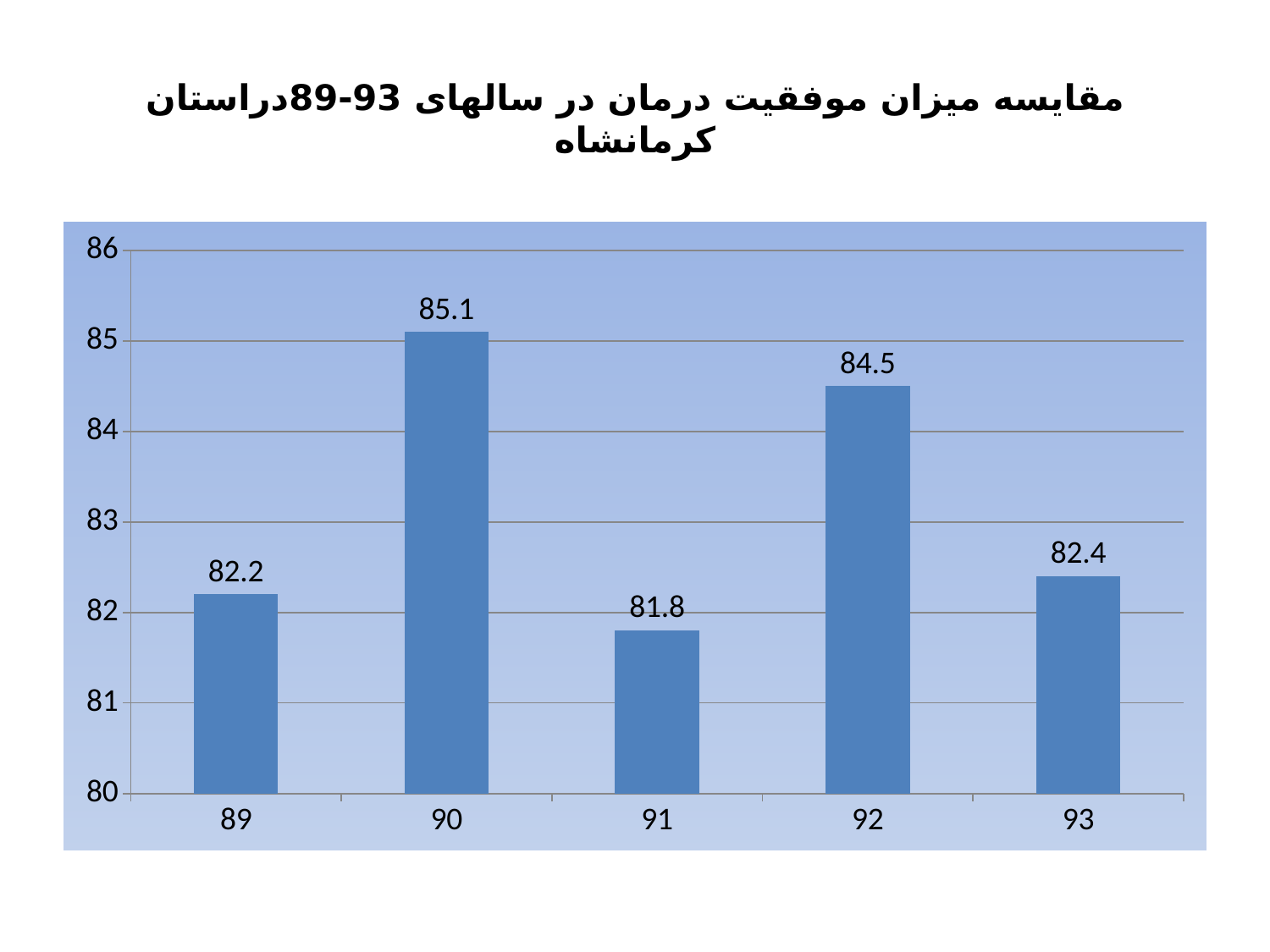
What is the value for year 93? 82.4 Which year has the lowest value? 91 Which year has the highest value? 90 Is the value for year 92 greater or less than 84? greater Which is larger, the value for year 92 or the value for year 93? 92 What is the value for year 89? 82.2 What kind of chart is shown on the slide? bar chart What is the value for year 92? 84.5 What is the value for year 91? 81.8 What is the value for year 90? 85.1 What is the difference between the values for years 90 and 91? 3.3 How many years are shown on the x axis? 5